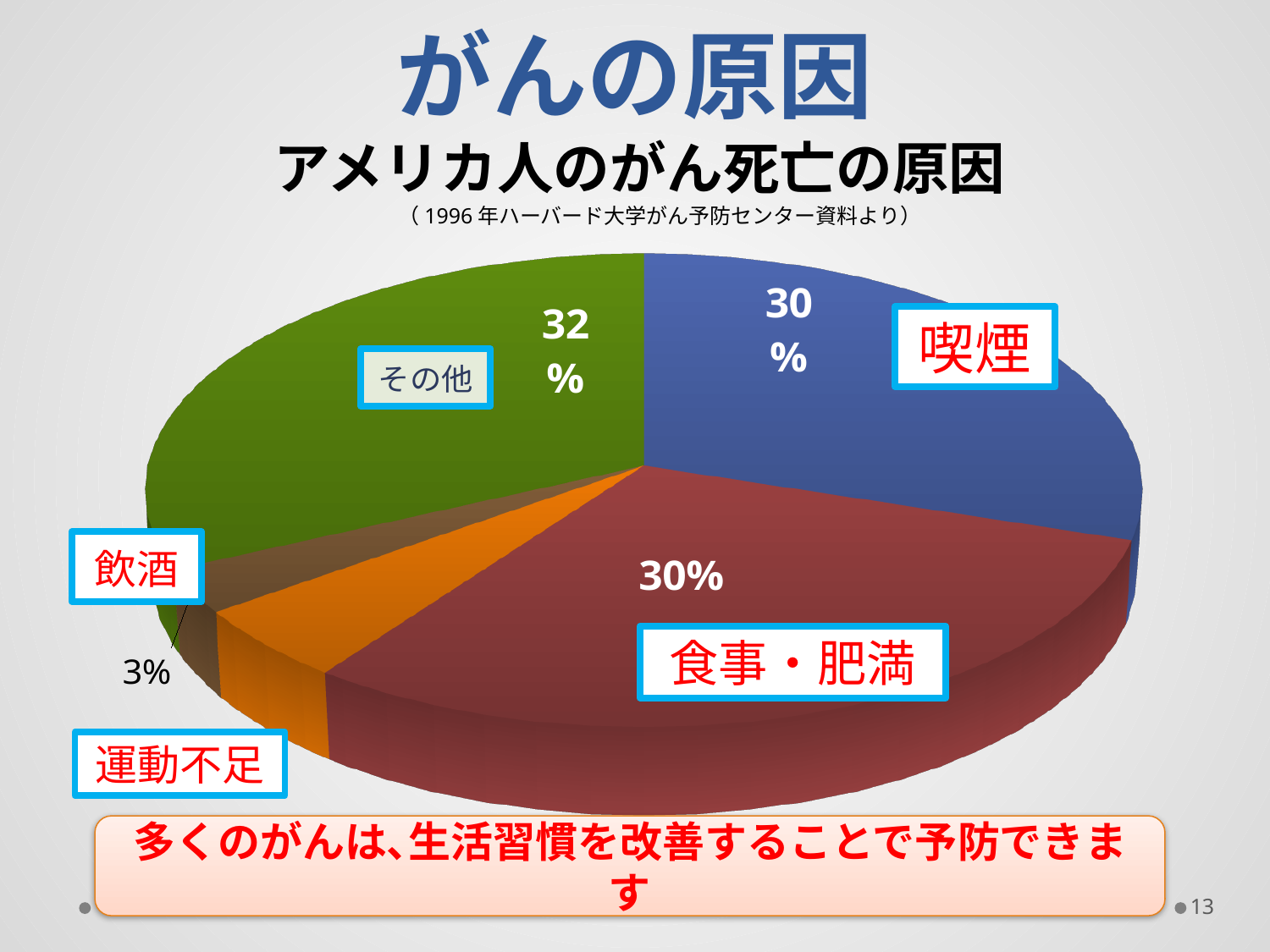
What is the difference between the その他 share and the 喫煙 share? 2% What is the difference between the 喫煙 share and the 飲酒 share? 27% What is the value shown for the その他 slice? 32% Which is larger, the share for その他 or the share for 喫煙? その他 Which category has the largest share of the pie chart? その他 How many slices does the pie chart have? 5 What percentage is shown for 飲酒? 3% Which category has the smallest share of the pie chart? 飲酒 What percentage does the 食事・肥満 slice represent? 30% What is the title of the chart? アメリカ人のがん死亡の原因 What percentage of the pie chart is attributed to 喫煙? 30% What type of chart is shown on the slide? Pie chart